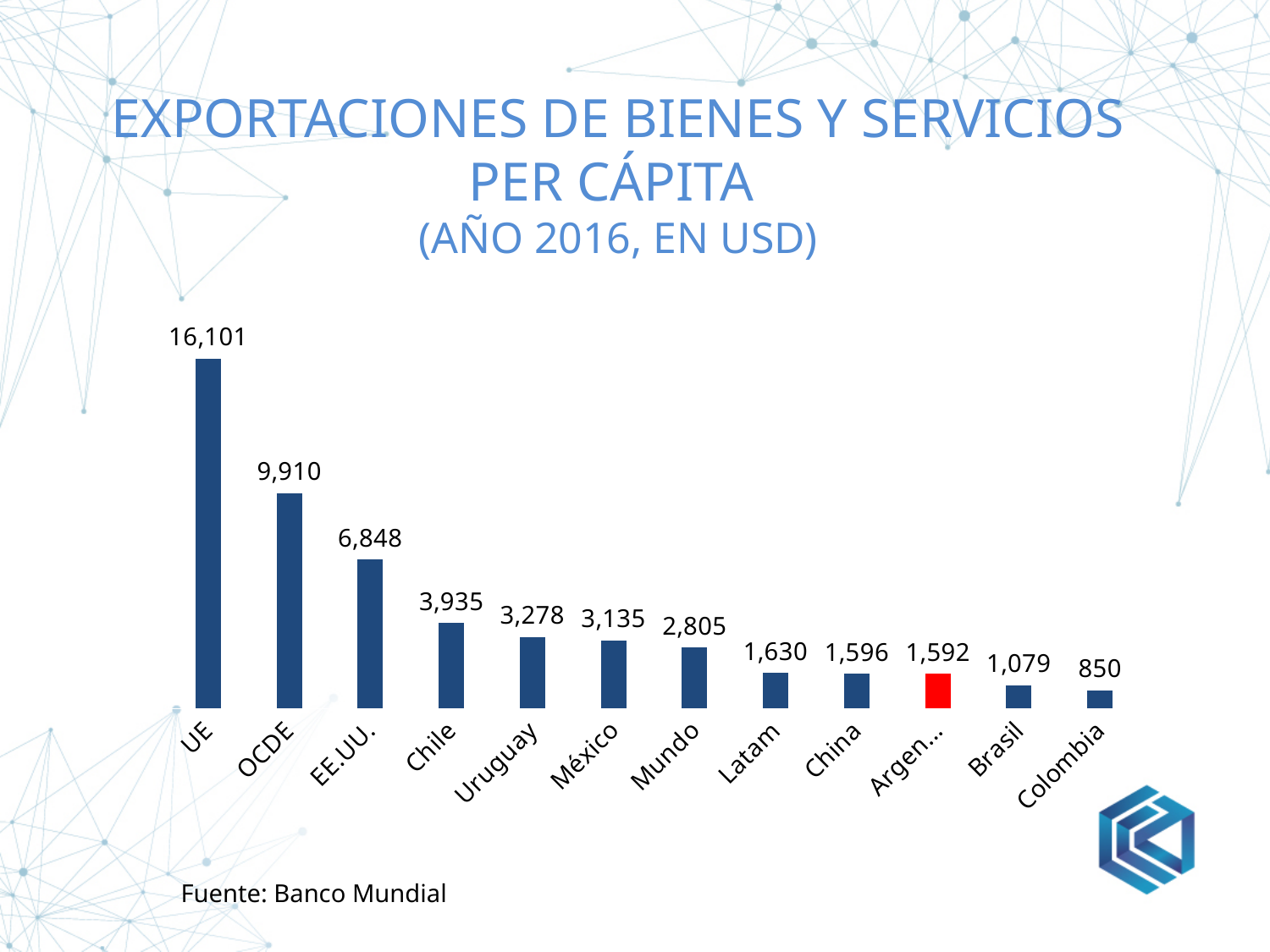
Which has a larger value, Latam or Brasil? Latam Which category has the highest value? UE What is the value for Colombia? 850 Which bar is coloured red instead of blue? The bar labelled Argen... (1,592) What is the value for UE? 16,101 What is the value for Mundo? 2,805 What is the value for Chile? 3,935 What is the difference between the values for OCDE and EE.UU.? 3,062 How many categories are shown in the chart? 12 What is the difference between the values for Uruguay and México? 143 Which category has the lowest value? Colombia What type of chart is shown on the slide? Bar chart